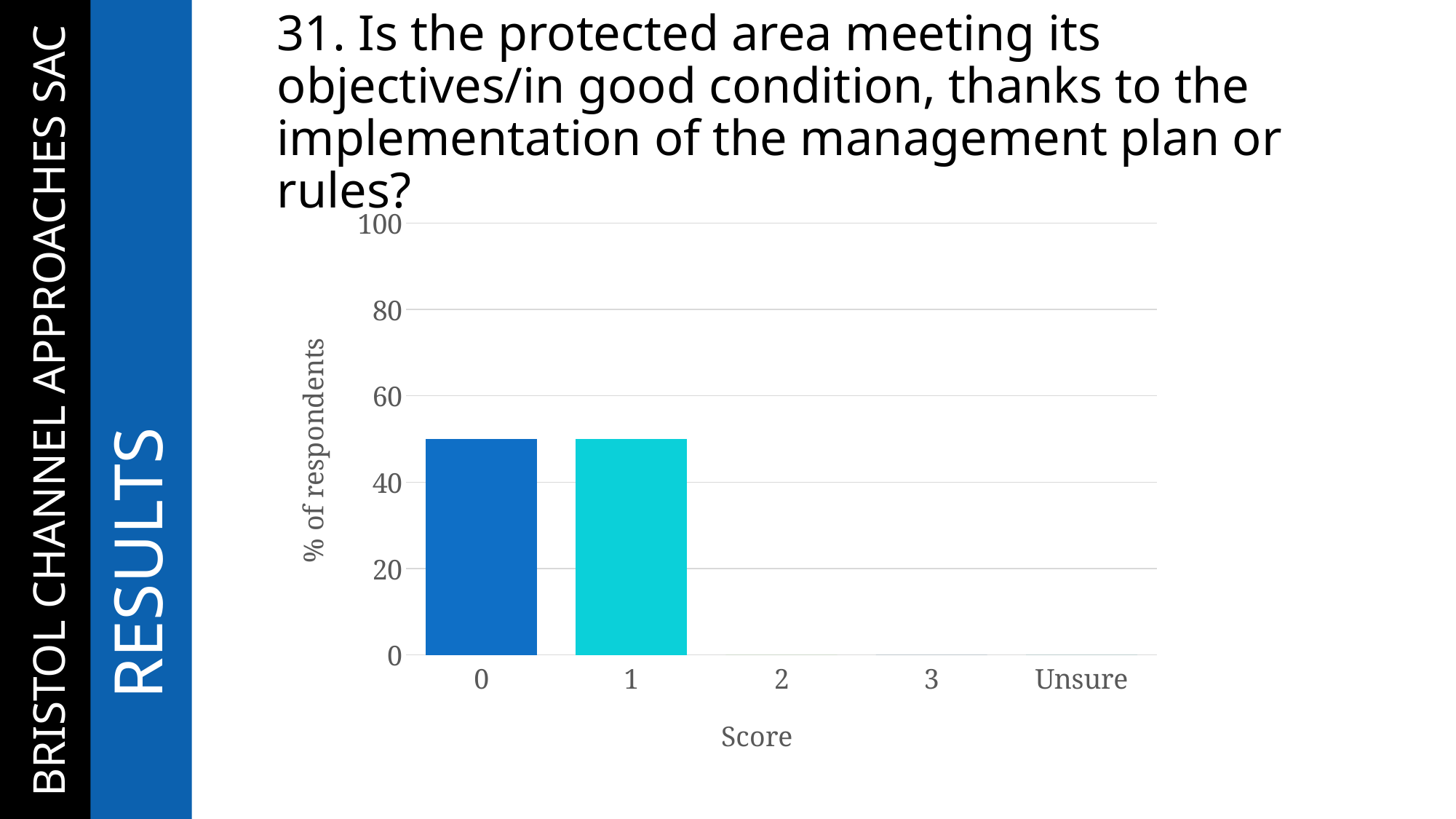
How many score categories are shown on the x axis? 5 What kind of chart is shown on the slide? bar chart Is the value for score 2 greater or less than 20? less Is the value for Unsure greater or less than 20? less What is the label of the x axis? Score Is the value for score 1 greater or less than 40? greater Is the value for score 0 greater or less than the value for score 3? greater What is the label of the y axis? % of respondents